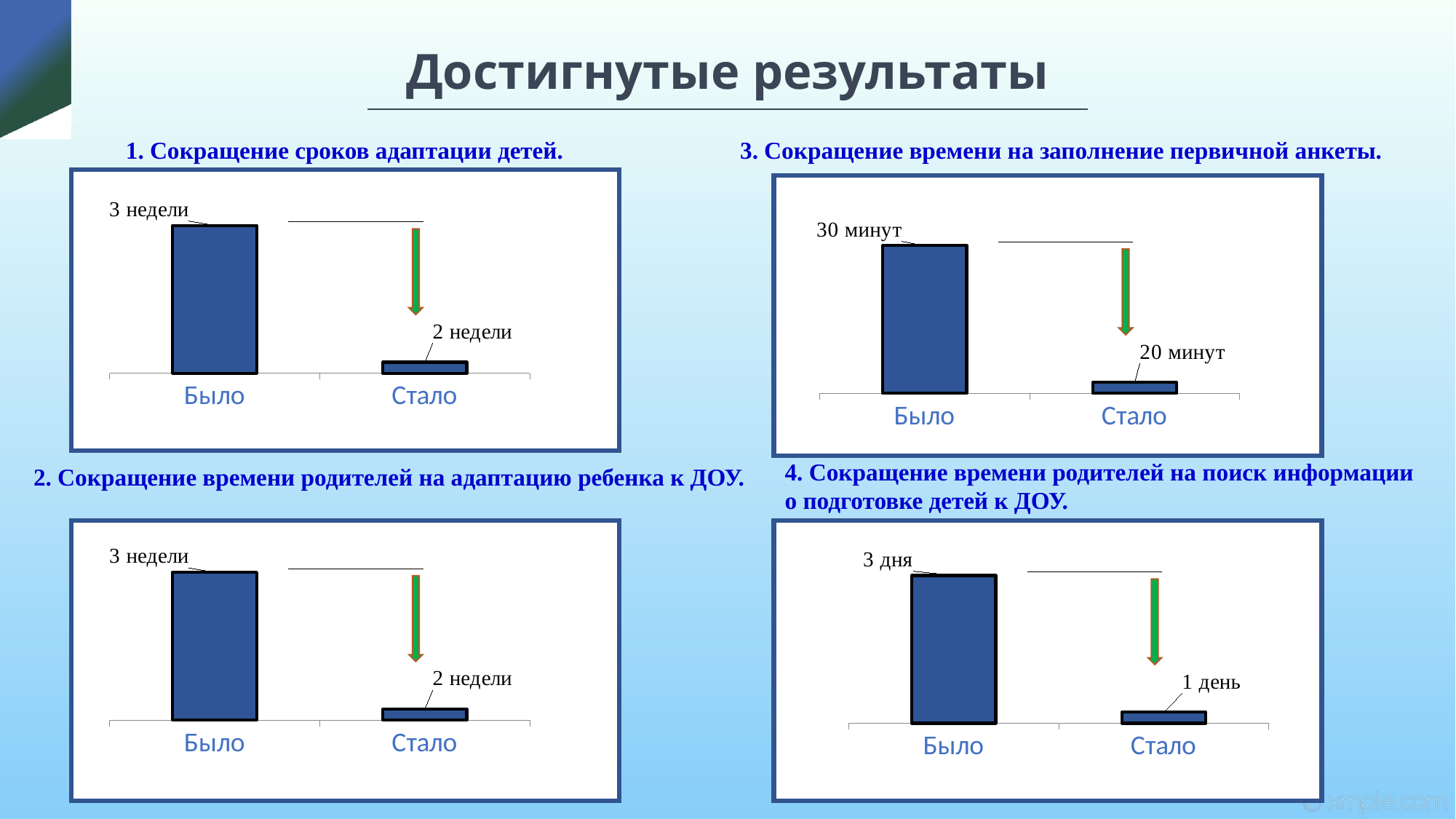
In the top-left chart ("Сокращение сроков адаптации детей"), what is the value for "Было"? 3 недели In the top-right chart ("Сокращение времени на заполнение первичной анкеты"), what is the value for "Стало"? 20 минут In the bottom-right chart ("Сокращение времени родителей на поиск информации о подготовке детей к ДОУ"), what is the difference between "Было" and "Стало"? 2 дня In the top-left chart ("Сокращение сроков адаптации детей"), what is the value for "Стало"? 2 недели In the bottom-right chart ("Сокращение времени родителей на поиск информации о подготовке детей к ДОУ"), what is the value for "Было"? 3 дня In the bottom-right chart ("Сокращение времени родителей на поиск информации о подготовке детей к ДОУ"), what is the value for "Стало"? 1 день In the top-right chart ("Сокращение времени на заполнение первичной анкеты"), by how many minutes is "Было" larger than "Стало"? 10 минут How many categories are shown on the x axis of the bottom-left chart ("Сокращение времени родителей на адаптацию ребенка к ДОУ")? 2 In the bottom-left chart ("Сокращение времени родителей на адаптацию ребенка к ДОУ"), what is the value for "Стало"? 2 недели What type of chart is the top-right chart ("Сокращение времени на заполнение первичной анкеты")? Bar chart In the top-left chart ("Сокращение сроков адаптации детей"), which category has the higher value, "Было" or "Стало"? Было In the top-right chart ("Сокращение времени на заполнение первичной анкеты"), what is the value for "Было"? 30 минут